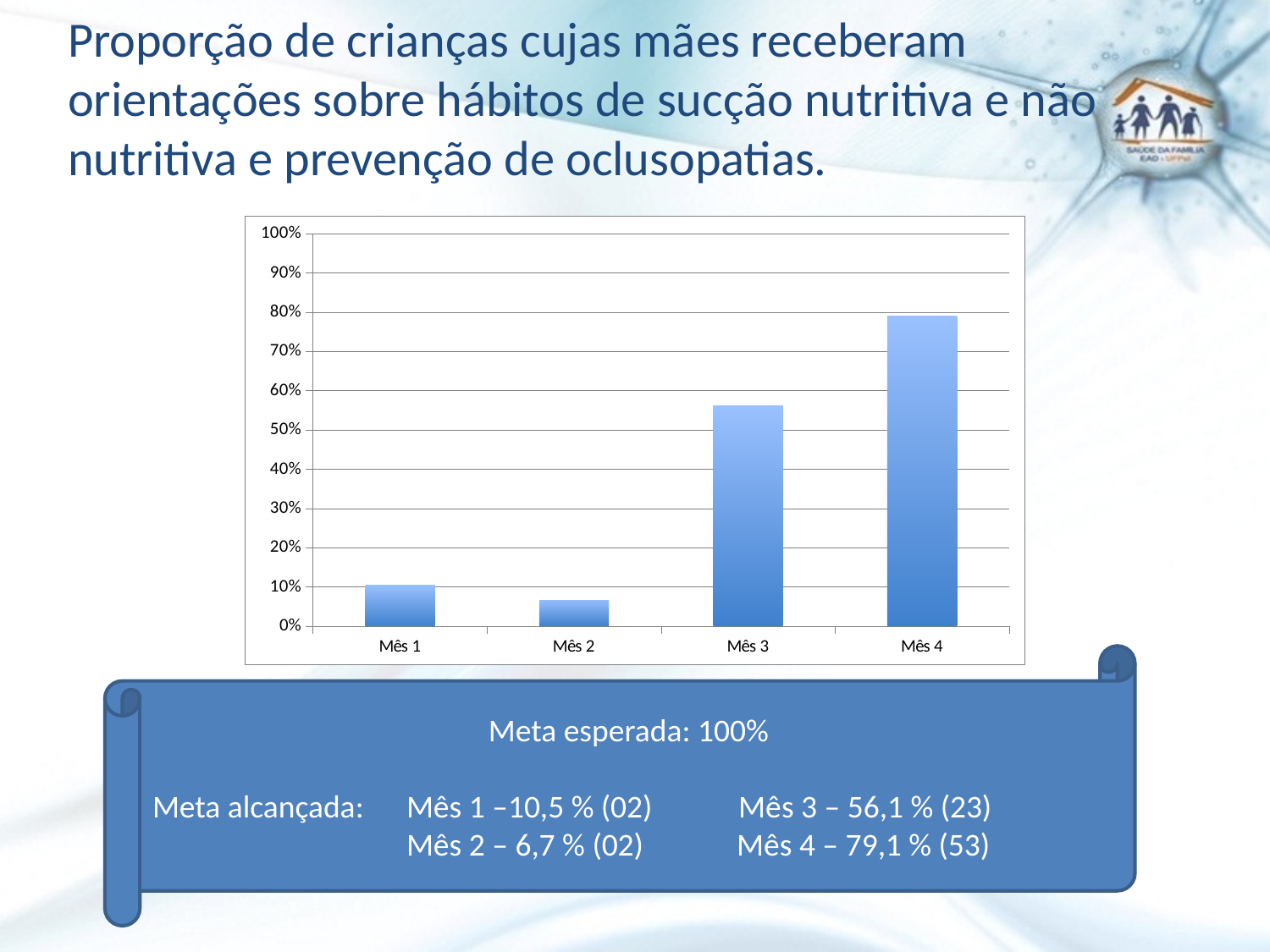
What is the expected target (meta esperada) stated on the slide? 100% How many months (categories) are shown on the x axis of the chart? 4 Is the value for Mês 1 greater or less than 20%? less According to the slide, what proportion was reached in Mês 3? 56,1 % Which month has the lowest bar in the chart? Mês 2 Which is larger, the value for Mês 1 or the value for Mês 2? Mês 1 What kind of chart is shown on the slide? bar chart Which month has the highest bar in the chart? Mês 4 According to the slide, what proportion was reached in Mês 4? 79,1 % Is the value for Mês 3 greater or less than 50%? greater What is the highest value shown on the y axis of the chart? 100% Is the value for Mês 4 greater or less than 80%? less